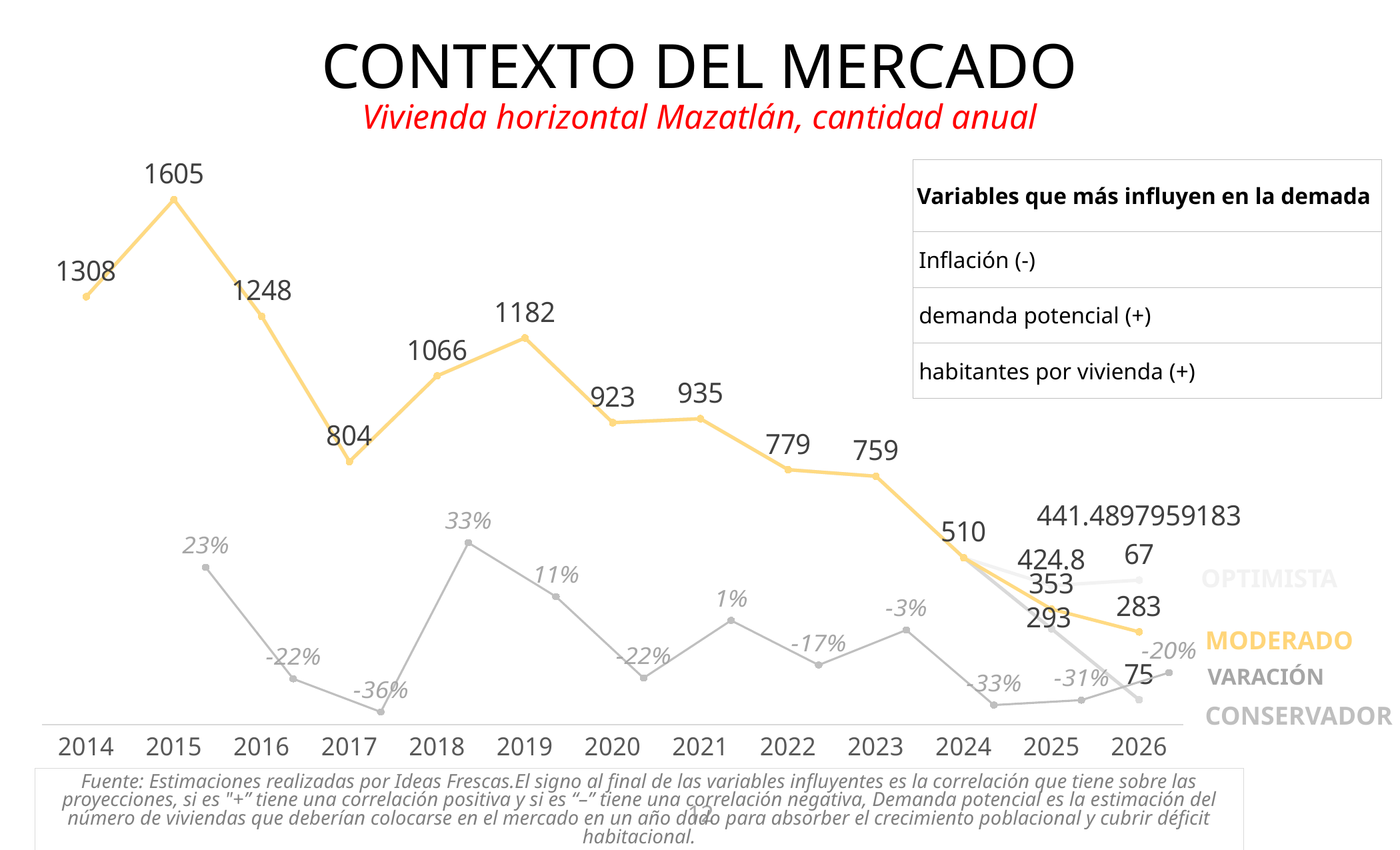
What kind of chart is shown on the slide? Line chart What is the VARIACIÓN value shown for 2018? 33% In which year does the MODERADO series reach its lowest value? 2026 What is the red subtitle of the chart? Vivienda horizontal Mazatlán, cantidad anual In which year does the MODERADO series reach its highest value? 2015 What is the difference between the MODERADO values for 2015 and 2014? 297 What is the MODERADO value for 2015? 1605 Does the MODERADO series rise or fall from 2019 to 2026? Fall What is the difference between the MODERADO values for 2023 and 2024? 249 Which year has the larger MODERADO value, 2020 or 2021? 2021 How many years are shown on the x axis? 13 What is the MODERADO value for 2017? 804